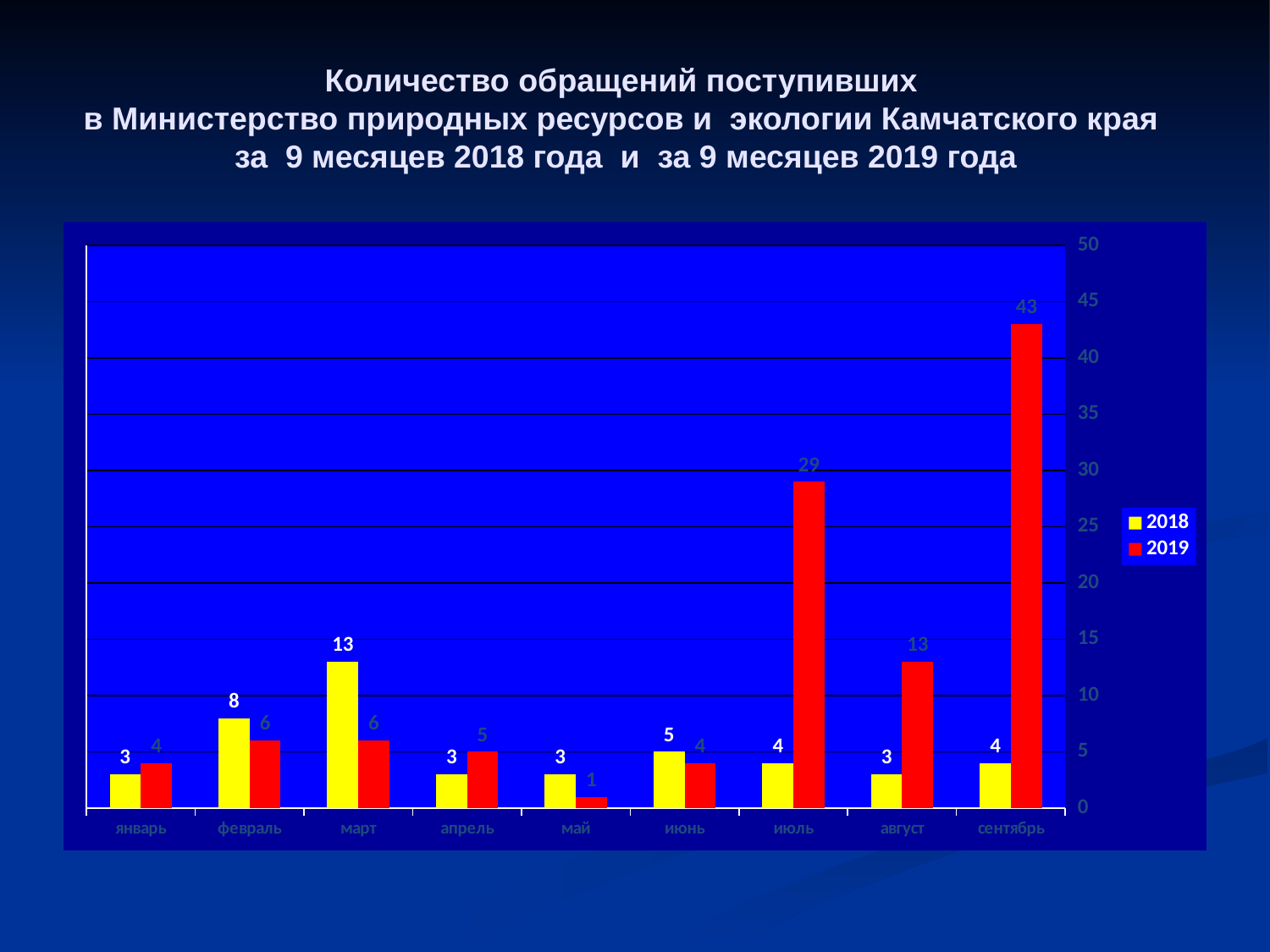
Which colour represents the 2019 series? red What type of chart is shown on the slide? bar chart How many months are shown on the x axis? 9 Which month has the lowest value for the 2019 series? май Which month has the highest value for the 2018 series? март What is the value for 2019 in сентябрь? 43 What is the value for 2019 in май? 1 How many series does the legend list? 2 What is the value for 2018 in март? 13 What is the difference between the 2019 and 2018 values in июль? 25 Which is larger in февраль, the 2018 value or the 2019 value? 2018 Which month has the highest value for the 2019 series? сентябрь